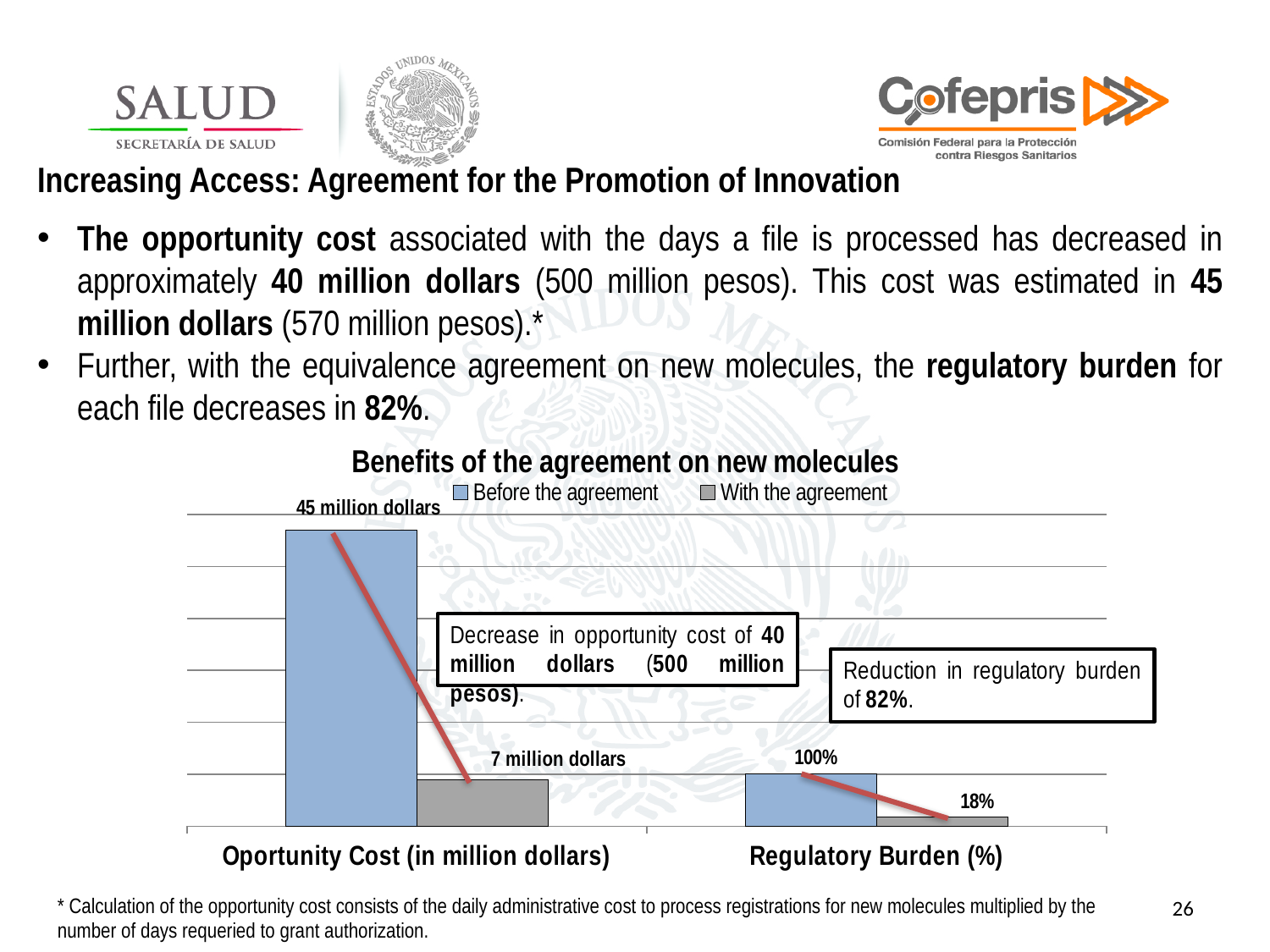
What is the difference between the 'Before the agreement' and 'With the agreement' values for Oportunity Cost (in million dollars)? 38 million dollars What are the two series named in the chart legend? Before the agreement; With the agreement Which series has the larger value for Regulatory Burden (%), 'Before the agreement' or 'With the agreement'? Before the agreement What is the value of 'Before the agreement' for Oportunity Cost (in million dollars)? 45 million dollars What is the value of 'With the agreement' for Regulatory Burden (%)? 18% What is the difference between the 'Before the agreement' and 'With the agreement' values for Regulatory Burden (%)? 82% What is the value of 'Before the agreement' for Regulatory Burden (%)? 100% What is the title of the chart? Benefits of the agreement on new molecules How many categories are shown on the x axis of the chart? 2 What is the value of 'With the agreement' for Oportunity Cost (in million dollars)? 7 million dollars What kind of chart is shown on the slide? bar chart How many series does the chart legend list? 2